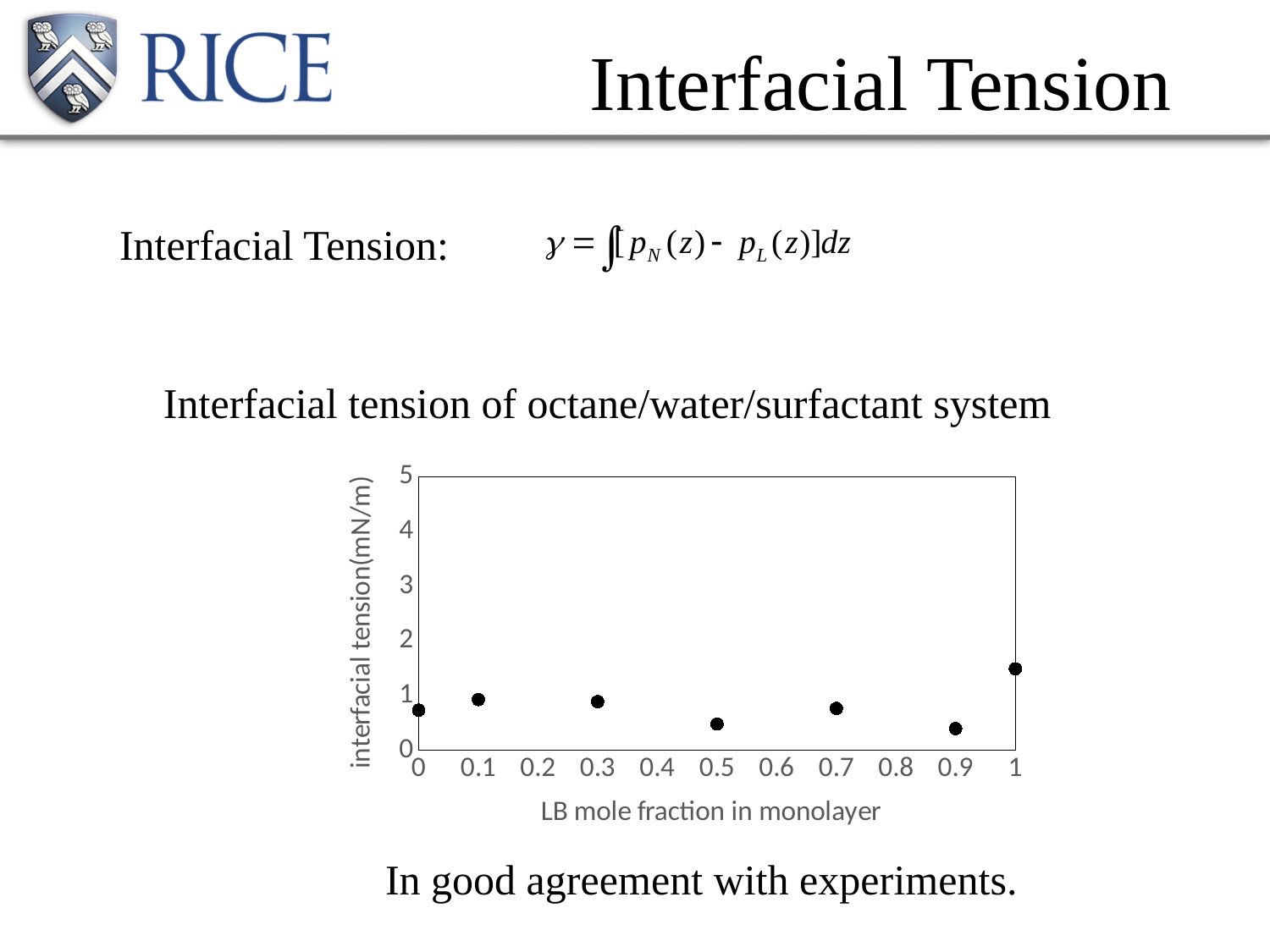
How many data points are plotted in the chart? 7 Is the interfacial tension at LB mole fraction 1 greater or less than 2 mN/m? less Is the interfacial tension at LB mole fraction 0.9 greater or less than 1 mN/m? less What is the label of the y axis of the chart? interfacial tension(mN/m) What kind of chart is shown on the slide? scatter chart Is the interfacial tension at LB mole fraction 0.5 greater or less than 1 mN/m? less Which has the larger interfacial tension: LB mole fraction 1 or 0? 1 Which has the larger interfacial tension: LB mole fraction 0.1 or 0.5? 0.1 Which has the larger interfacial tension: LB mole fraction 0.3 or 0.9? 0.3 What is the label of the x axis of the chart? LB mole fraction in monolayer At which LB mole fraction is the interfacial tension highest? 1